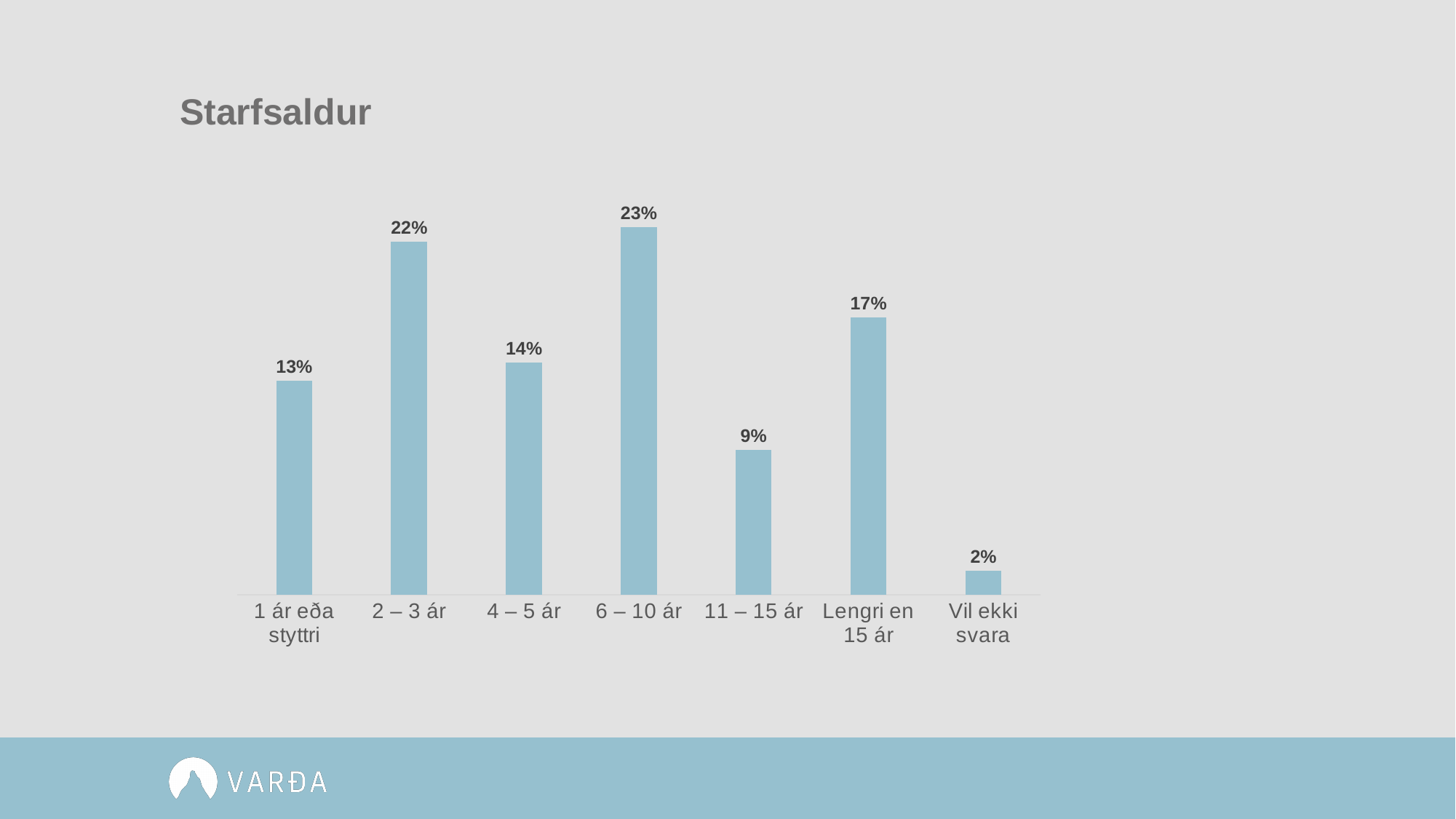
What is the difference between the values for '6 – 10 ár' and '1 ár eða styttri'? 10% Which is larger, the value for '4 – 5 ár' or the value for 'Lengri en 15 ár'? Lengri en 15 ár What is the value for the '6 – 10 ár' category? 23% What is the title of the chart? Starfsaldur What is the value for the '1 ár eða styttri' category? 13% What is the difference between the values for '2 – 3 ár' and '11 – 15 ár'? 13% What is the value for the 'Lengri en 15 ár' category? 17% What is the value for the 'Vil ekki svara' category? 2% Which category has the lowest value? Vil ekki svara Which category has the highest value? 6 – 10 ár How many categories are shown on the x axis? 7 What kind of chart is shown on the slide? Bar chart